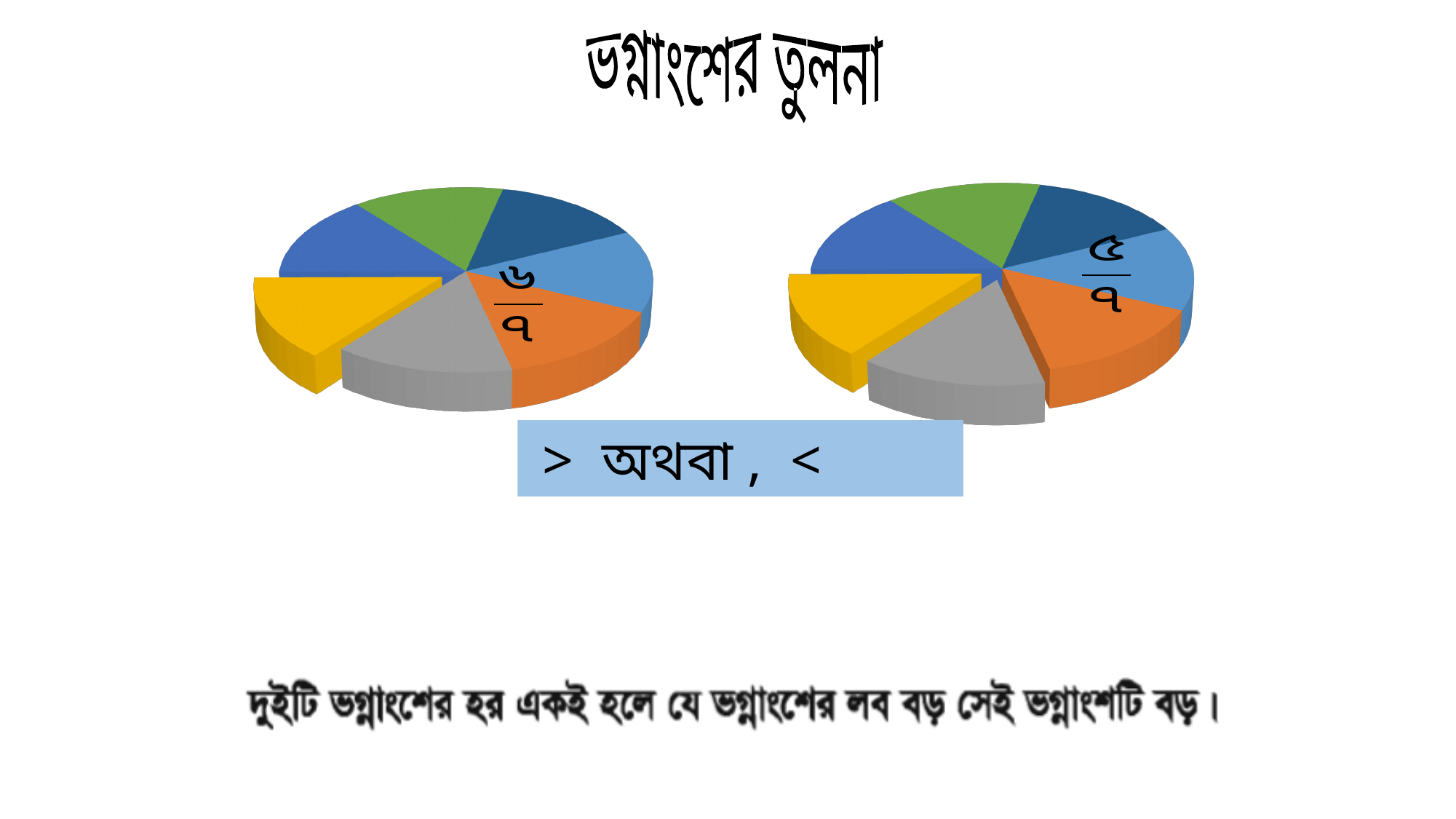
What kind of chart is shown on the right side of the slide? Pie chart How many slices does the right pie chart have? 7 Which pie chart shows the larger fraction, the left one (৬/৭) or the right one (৫/৭)? The left one (৬/৭) What fraction is printed on the right pie chart? ৫/৭ How many pie charts are on the slide? 2 How many slices does the left pie chart have? 7 What fraction is printed on the left pie chart? ৬/৭ What colour is the slice that is pulled out from the left pie chart on its left side? Yellow What is the title of the slide above the pie charts? ভগ্নাংশের তুলনা What kind of chart is shown on the left side of the slide? Pie chart